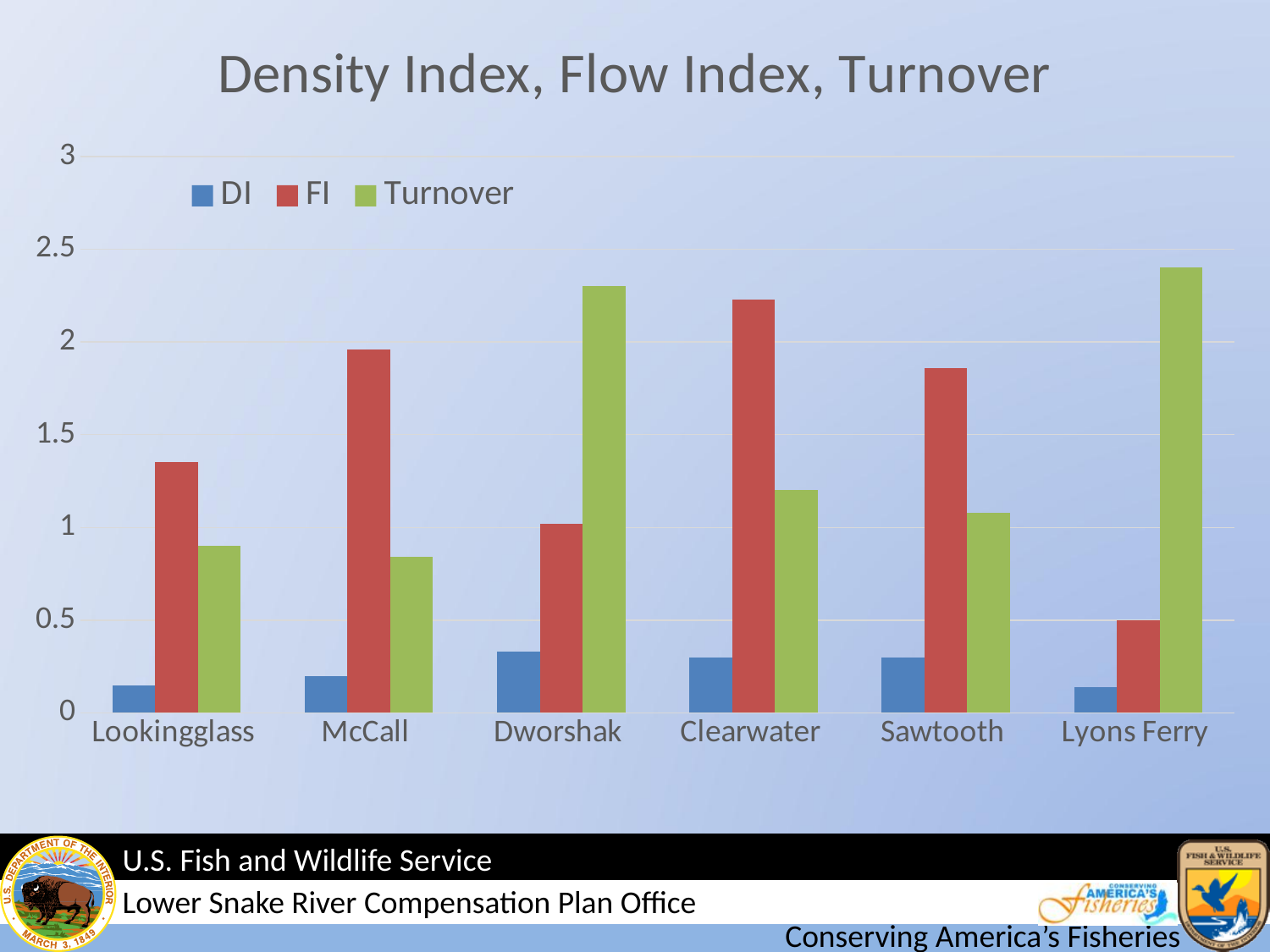
What is the title of the chart? Density Index, Flow Index, Turnover What kind of chart is shown on the slide? bar chart Is the FI value for Lyons Ferry greater or less than 1? less Which hatchery has the lowest FI value? Lyons Ferry How many hatcheries (categories) are shown on the x axis? 6 Which hatchery has the highest FI value? Clearwater Is the DI value for Sawtooth greater or less than 0.5? less Is the Turnover value for Lookingglass greater or less than 1? less How many series does the legend list? 3 For Clearwater, which is larger: FI or Turnover? FI